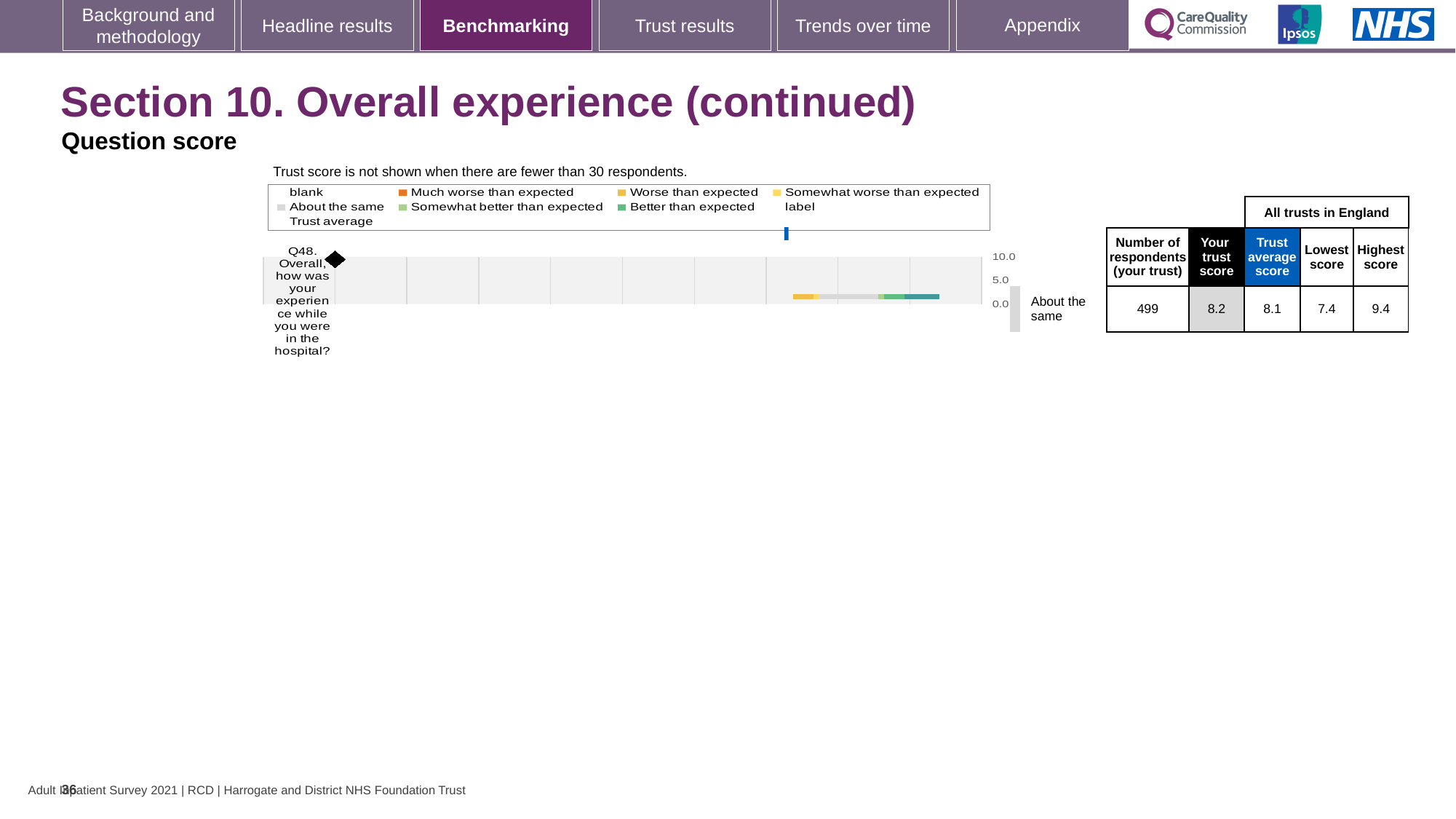
What is the trust score for Q48 shown in the table next to the chart? 8.2 What is the lowest score among all trusts in England for Q48? 7.4 What is the trust average score for Q48? 8.1 Which legend entry is shown in orange? Much worse than expected How many respondents from the trust answered Q48? 499 What kind of chart is used to show the benchmarking for Q48? bar chart What is the maximum value shown on the chart's score axis? 10.0 What benchmark category is the trust's Q48 score placed in? About the same How many questions are plotted on the chart? 1 What is the highest score among all trusts in England for Q48? 9.4 Which is larger for Q48, the trust score or the trust average score? trust score What is the difference between the highest score and the lowest score for Q48? 2.0